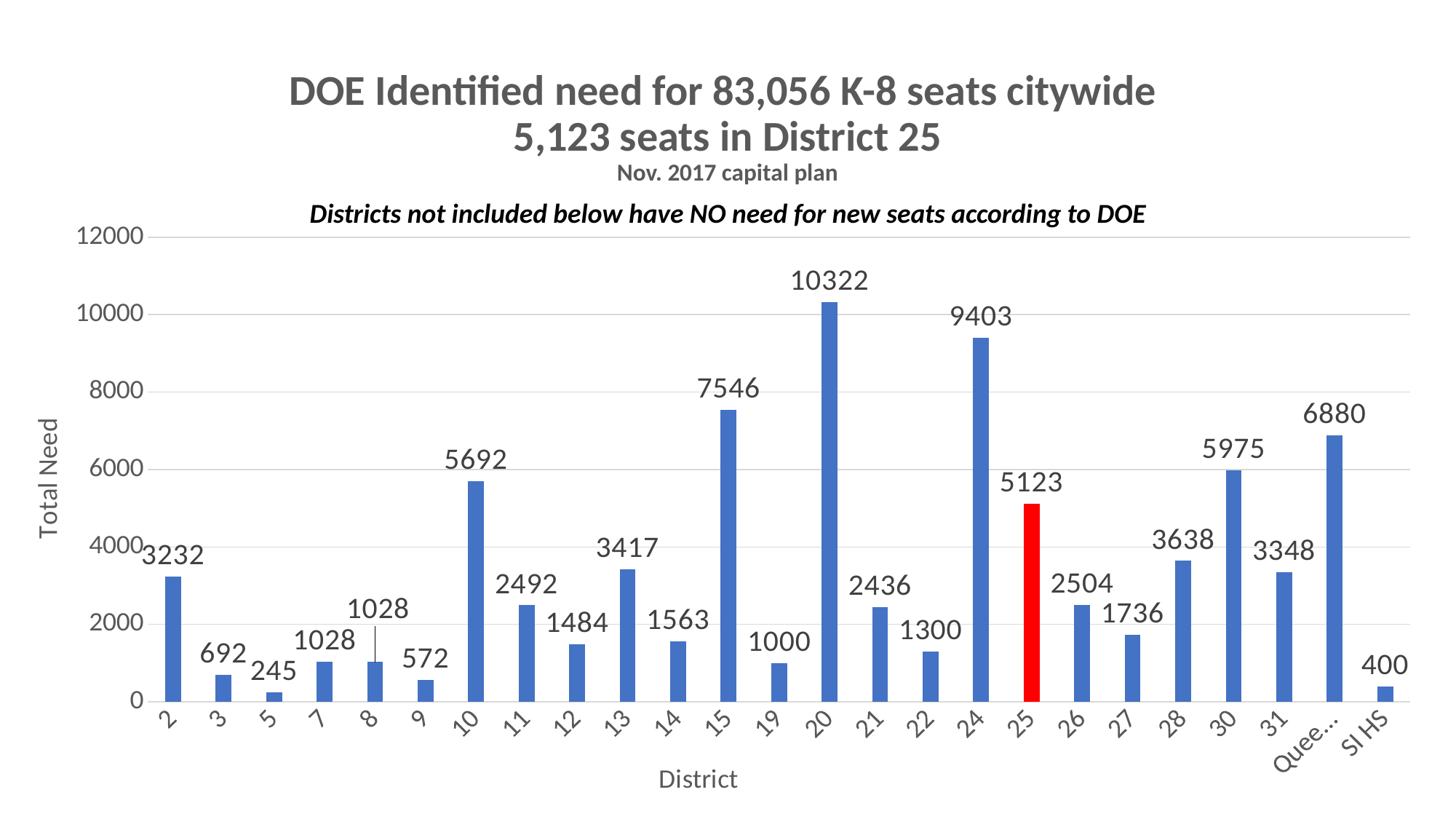
What type of chart is shown on the slide? Bar chart Which district has the highest total need? 20 What is the difference in total need between District 20 and District 24? 919 What is the total need for District 25? 5123 What is the total need for District 20? 10322 Which district has the lowest total need? 5 What is the difference in total need between District 10 and District 25? 569 What is the total need for District 15? 7546 How many districts are shown on the x axis? 25 What is the total need for SI HS? 400 Which district's bar is coloured red? 25 Which has a larger total need, District 30 or District 28? District 30